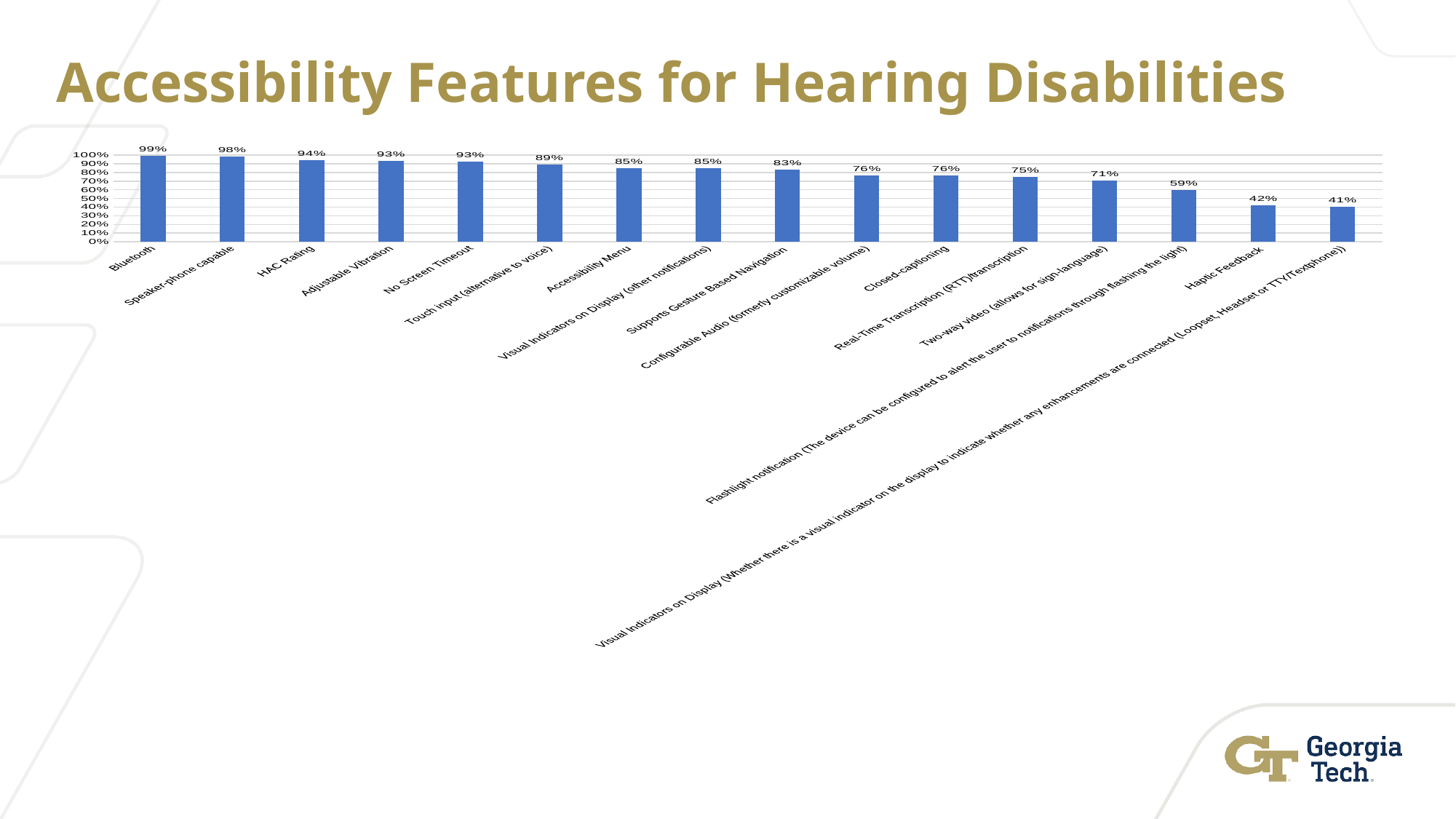
Do the values rise or fall from left to right along the x axis? Fall What is the value for Bluetooth? 99% What kind of chart is shown on the slide? Bar chart How many categories are shown in the chart? 16 Which category has the highest value? Bluetooth What is the value for Closed-captioning? 76% What is the difference between the values for HAC Rating and Haptic Feedback? 52% What is the value for Two-way video (allows for sign-language)? 71% What is the title of the slide? Accessibility Features for Hearing Disabilities Which category has the lowest value? Visual Indicators on Display (Whether there is a visual indicator on the display to indicate whether any enhancements are connected (Loopset, Headset or TTY/Textphone)) What is the value for Haptic Feedback? 42% Which is larger, the value for Accessibility Menu or the value for Real-Time Transcription (RTT)/transcription? Accessibility Menu